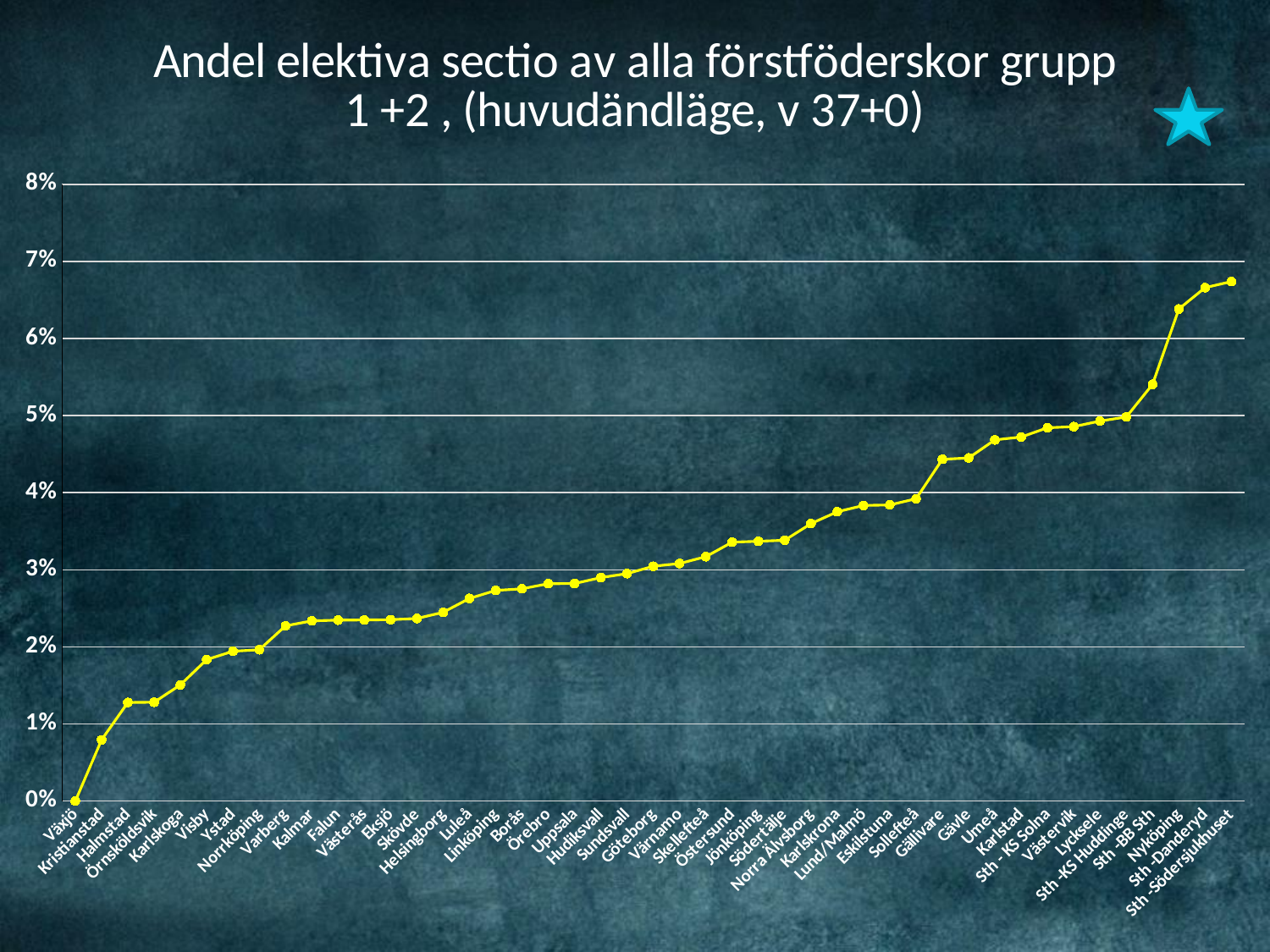
What kind of chart is shown on the slide? line chart Do the values rise or fall from left to right along the x axis? rise Is the value for Gällivare greater or less than 4%? greater What is the value for Växjö? 0% Which category has the lowest value? Växjö Which category has the highest value? Sth-Södersjukhuset How many categories are plotted on the x axis? 45 What colour is the plotted line? yellow Which has the larger value, Umeå or Luleå? Umeå Is the value for Nyköping greater or less than 6%? greater Is the value for Kristianstad greater or less than 1%? less